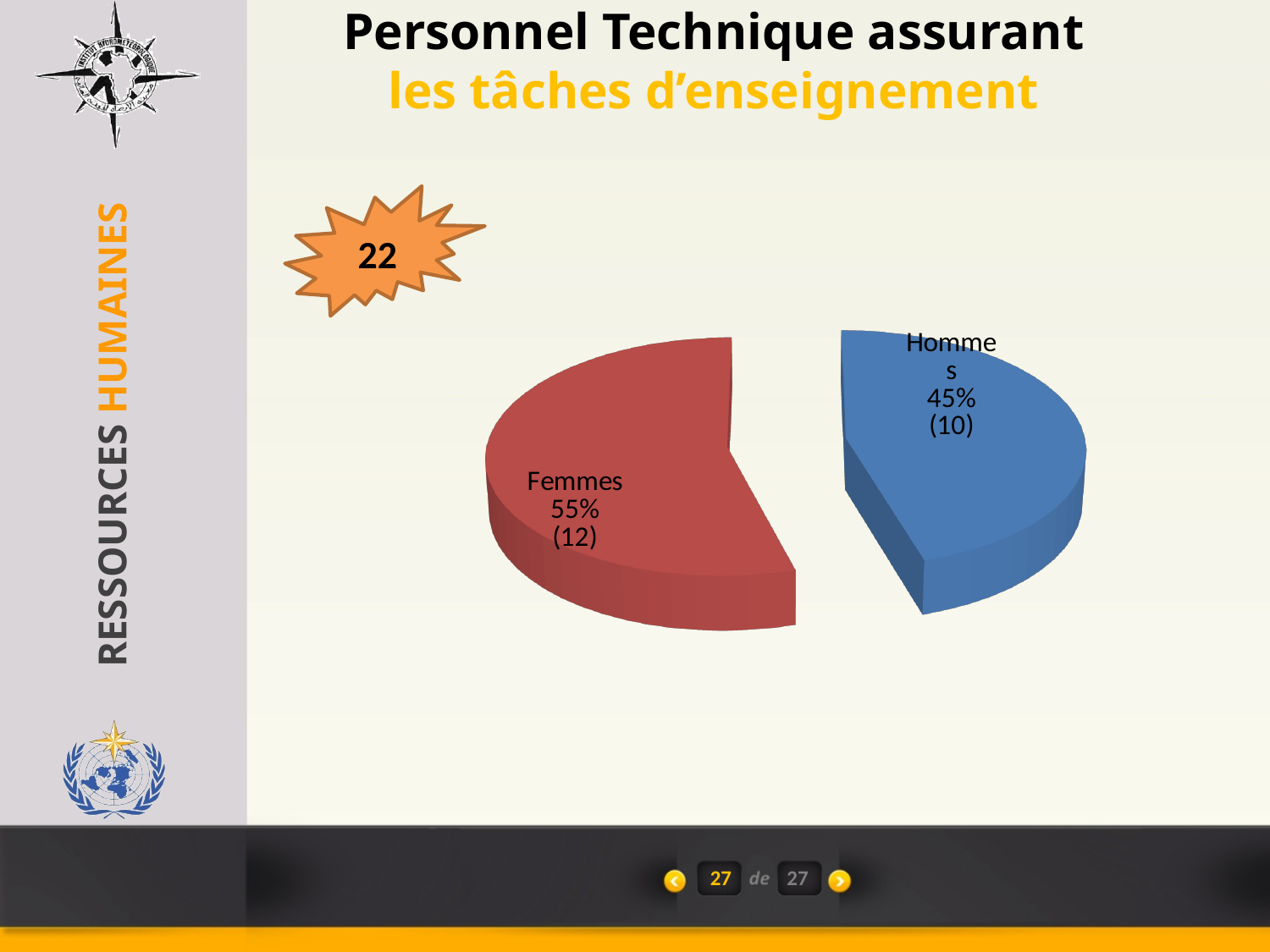
How many people does the Femmes slice represent? 12 What is the total number of people represented in the pie chart? 22 Which slice is the smallest? Hommes What percentage of the pie is Femmes? 55% What kind of chart is shown on the slide? pie chart Which is larger, the Femmes slice or the Hommes slice? Femmes What percentage of the pie is Hommes? 45% How many people does the Hommes slice represent? 10 What is the difference in count between Femmes and Hommes? 2 Which slice is the largest? Femmes How many slices does the pie chart have? 2 What colour is the Femmes slice? red